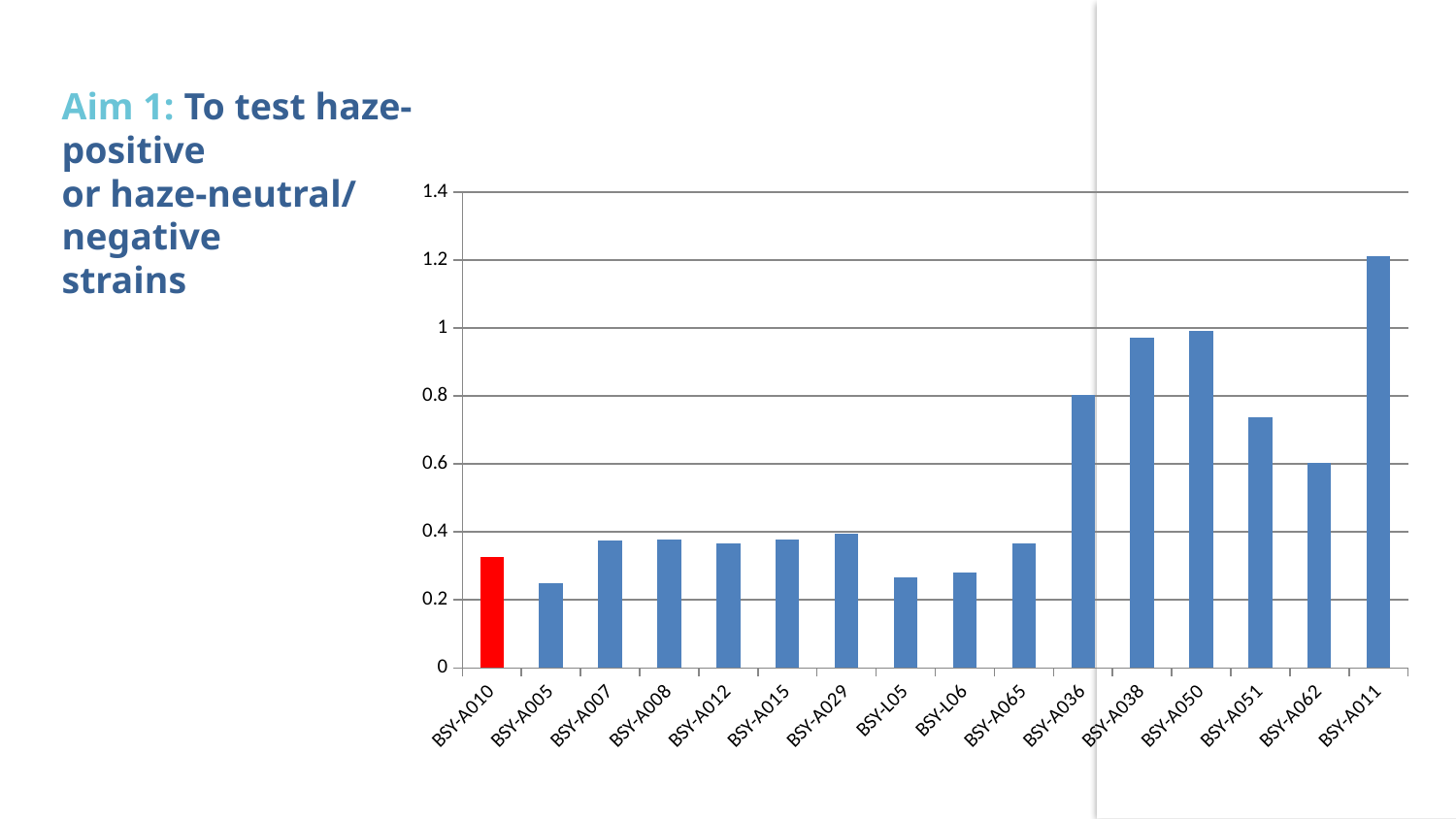
Which has the larger value, BSY-A011 or BSY-A050? BSY-A011 Is the value for BSY-A038 greater or less than 1? less Which strain's bar is coloured red in the chart? BSY-A010 Which has the larger value, BSY-A051 or BSY-A062? BSY-A051 How many strains (categories) are plotted on the x axis of the chart? 16 Is the value for BSY-A051 greater or less than 0.6? greater Is the value for BSY-A011 greater or less than 1? greater Which has the larger value, BSY-A036 or BSY-A065? BSY-A036 What kind of chart is shown on the slide? bar chart Which strain has the highest bar in the chart? BSY-A011